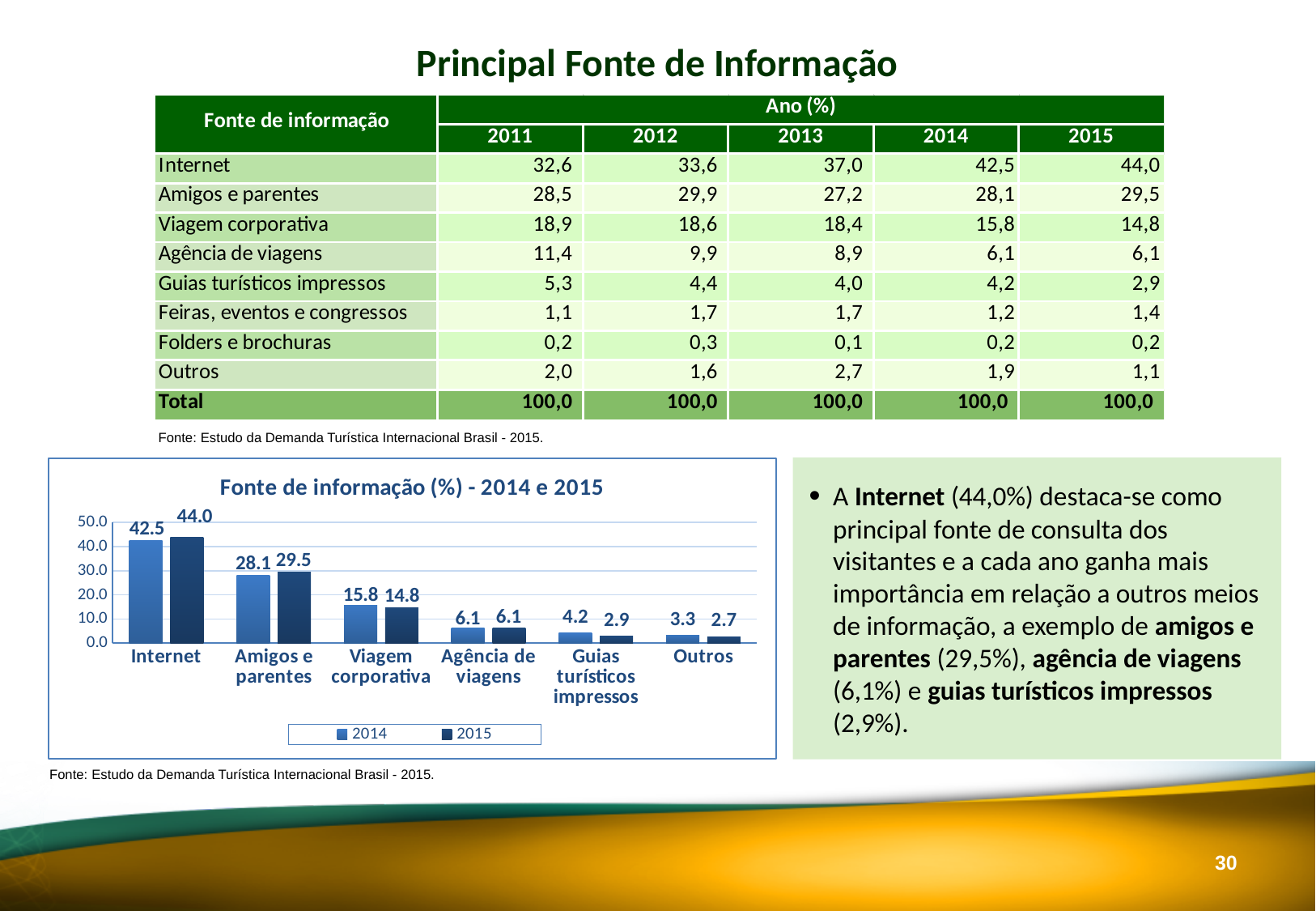
How many series does the chart legend list? 2 What is the value for Amigos e parentes in 2014 in the chart? 28.1 What is the title of the chart? Fonte de informação (%) - 2014 e 2015 Which category has the highest value for 2015 in the chart? Internet What is the value for Outros in 2014 in the chart? 3.3 Which is larger in the chart: Viagem corporativa in 2014 or in 2015? 2014 Which category has the lowest value for 2015 in the chart? Outros What type of chart is shown on the slide? Bar chart What is the difference between the 2015 and 2014 values for Internet in the chart? 1.5 What is the value for Internet in 2015 in the chart? 44.0 How many categories are shown on the x axis of the chart? 6 What is the value for Viagem corporativa in 2015 in the chart? 14.8